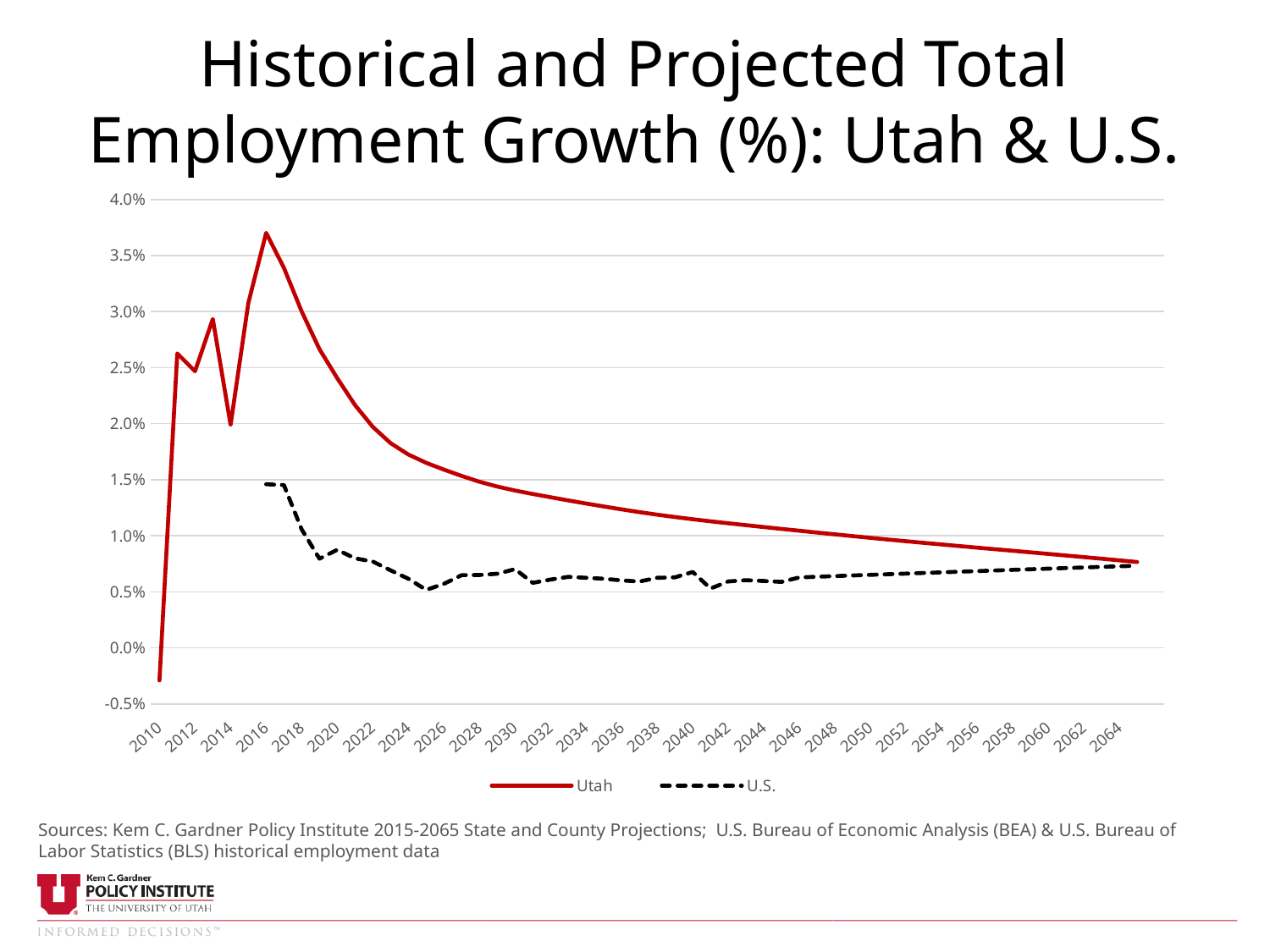
How many series does the legend list? 2 Which series is drawn with a dashed line? U.S. What are the two series named in the legend? Utah and U.S. In 2030, which series has the larger value, Utah or U.S.? Utah Is the Utah value in 2064 greater or less than 1.0%? less Is the Utah value in 2010 greater or less than 0.0%? less Is the U.S. value in 2025 greater or less than 1.0%? less Which series reaches the highest value on the chart? Utah What kind of chart is shown on the slide? line chart In which year does the Utah line reach its peak? 2016 From 2016 to 2064, does the Utah line rise or fall? fall